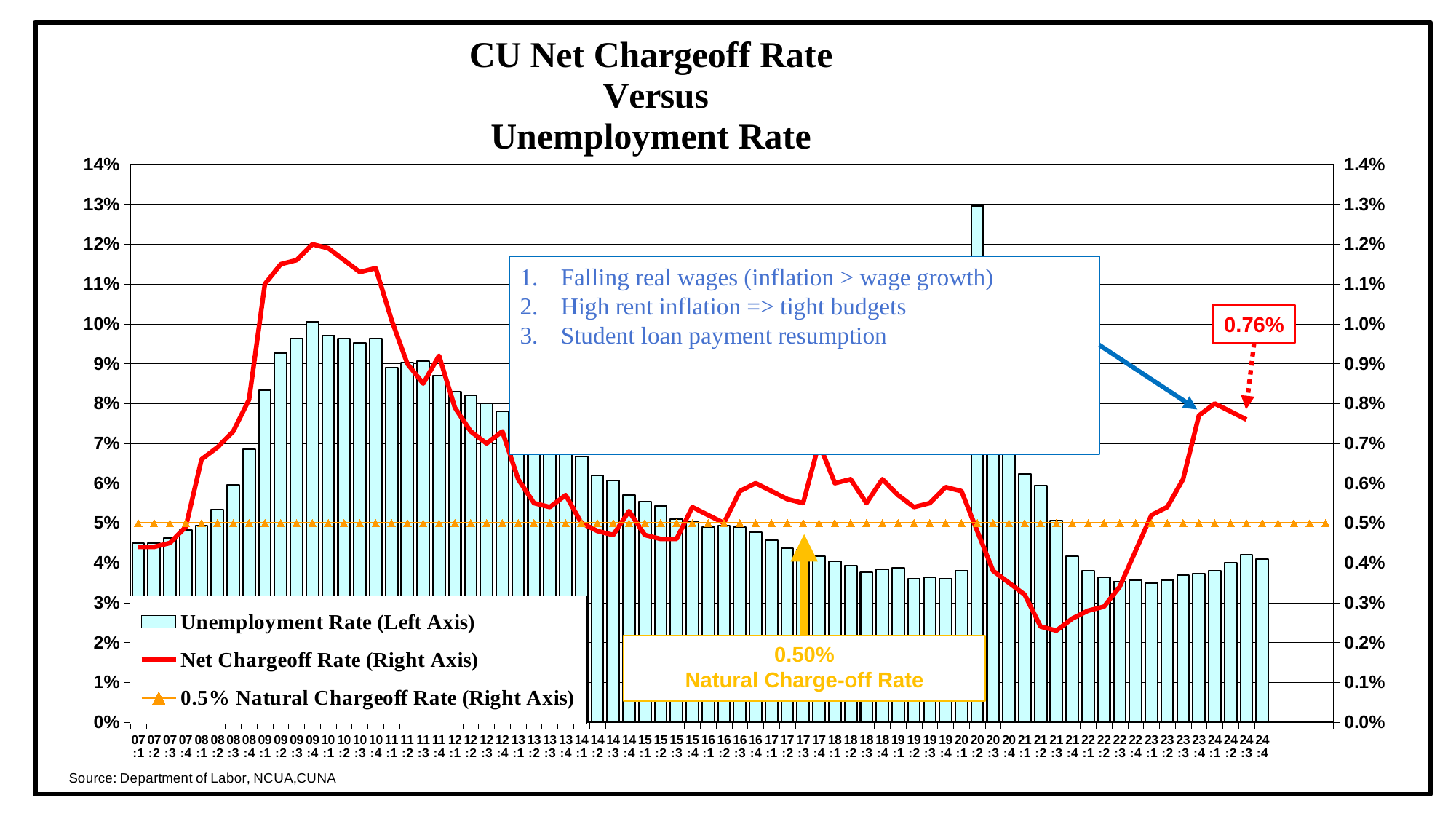
Is the Net Chargeoff Rate for 09:4 greater or less than 1.1%? greater Is the Unemployment Rate for 20:2 greater or less than 12%? greater Is the Net Chargeoff Rate for 21:3 greater or less than 0.3%? less What value does the Natural Chargeoff Rate line sit at? 0.50% On which axis is the Unemployment Rate plotted? Left Axis What is the labeled value of the Net Chargeoff Rate at the end of the series? 0.76% How many series does the legend list? 3 What kind of chart is shown on the slide? A combination bar and line chart Does the Unemployment Rate rise or fall from 21:1 to 21:4? fall Which quarter has the highest Unemployment Rate? 20:2 What is the title of the chart? CU Net Chargeoff Rate Versus Unemployment Rate